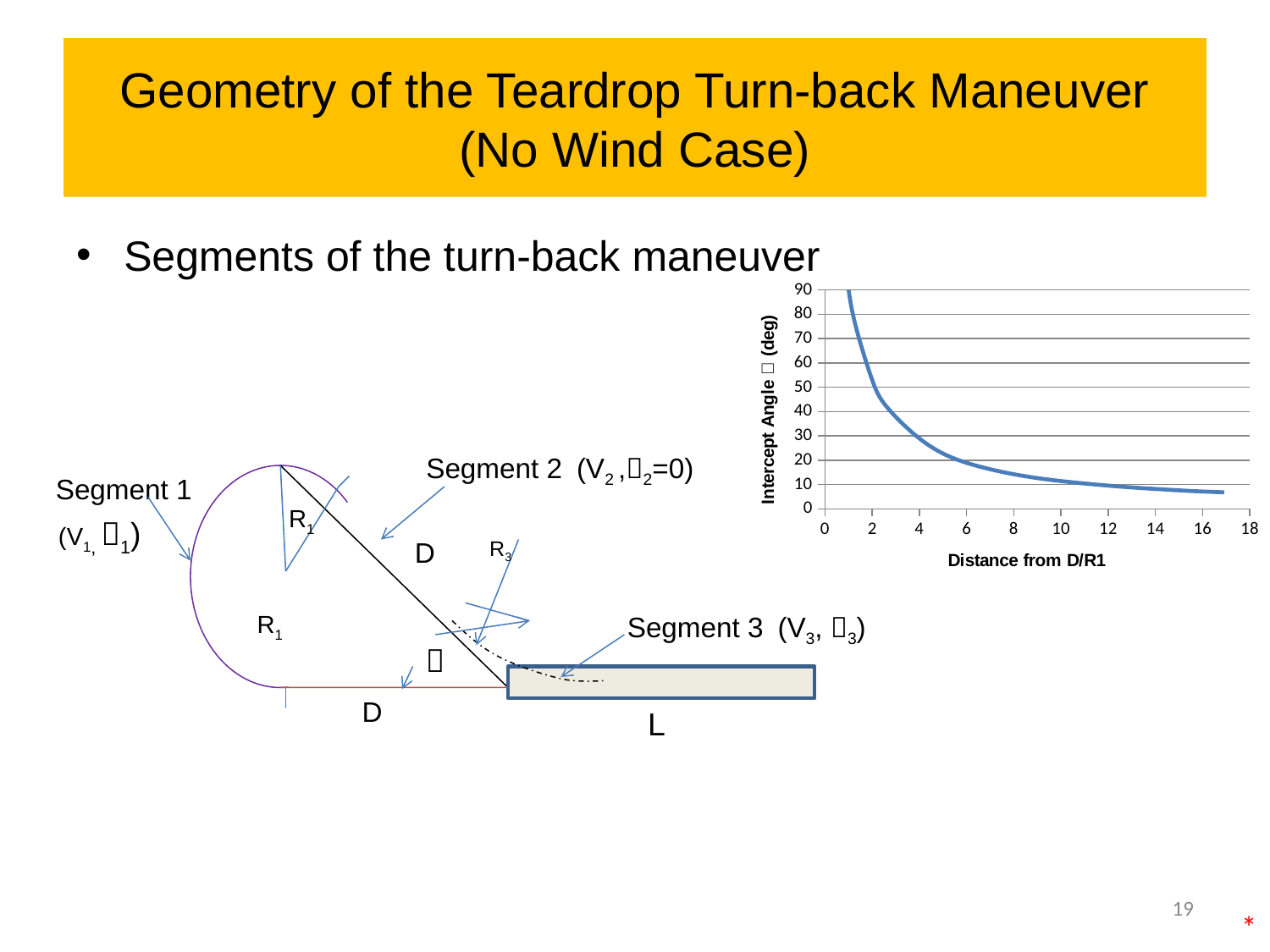
In the chart on the right, is the intercept angle at a distance of 16 greater or less than 10? less In the chart on the right, is the intercept angle at a distance of 2 greater or less than 40? greater In the chart on the right, does the intercept angle rise or fall as the distance from D/R1 increases? fall What is the title of the horizontal axis of the chart on the right? Distance from D/R1 What kind of chart is shown on the right of the slide? line chart In the chart on the right, is the intercept angle at a distance of 10 greater or less than 20? less In the chart on the right, is the intercept angle larger at a distance of 2 or at a distance of 8? 2 What is the highest value shown on the vertical axis of the chart on the right? 90